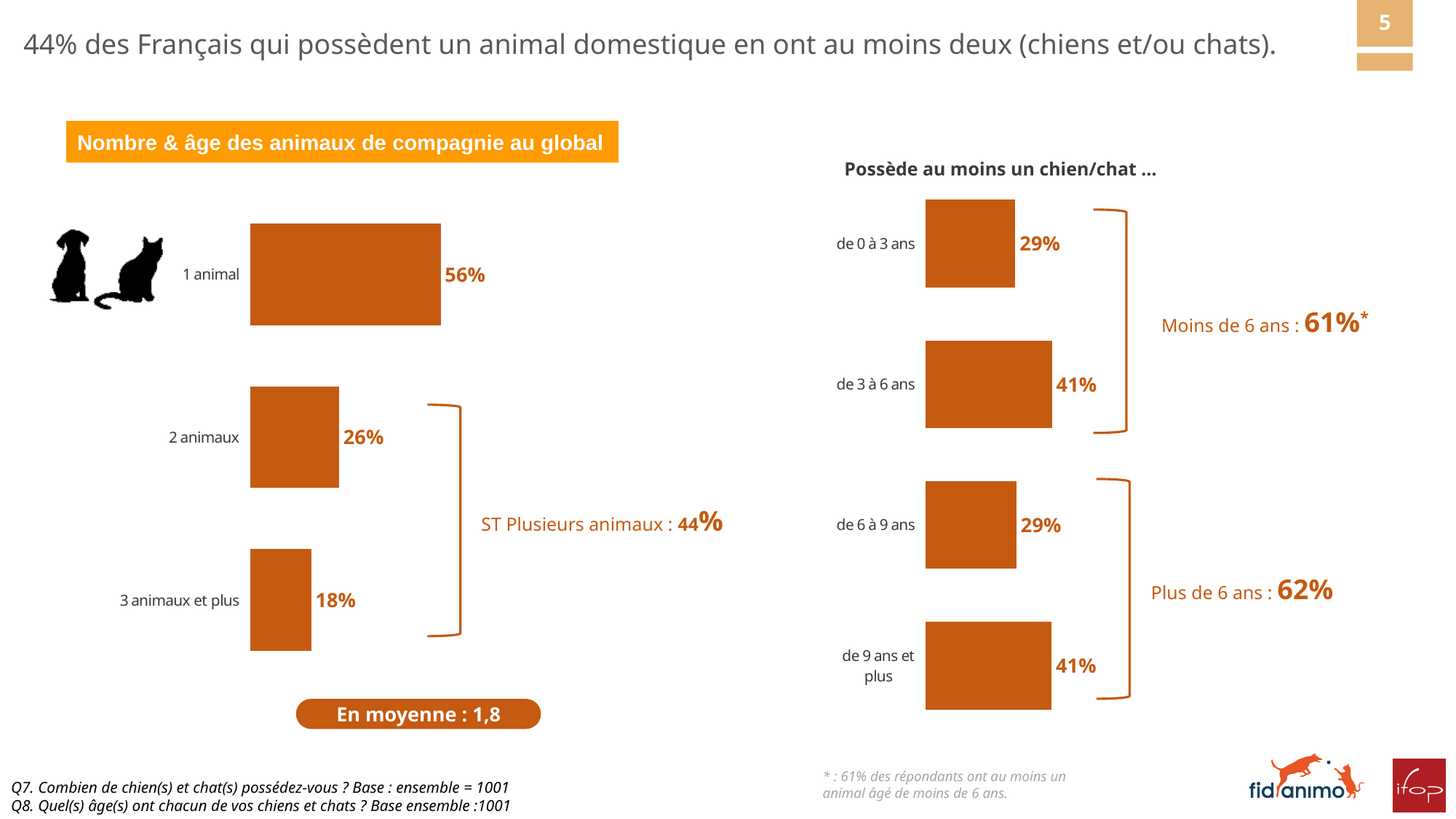
What is the value shown for 'ST Plusieurs animaux' on the left chart? 44% In the left chart (number of animals), how many categories are shown? 3 In the left chart (number of animals), which category has the lowest value? 3 animaux et plus In the left chart (number of animals), which category has the highest value? 1 animal In the left chart (number of animals), what is the value for '3 animaux et plus'? 18% What type of chart is used on the left side of the slide? Bar chart In the right chart ('Possède au moins un chien/chat ...'), what is the value for 'de 6 à 9 ans'? 29% In the left chart (number of animals), what is the difference between '1 animal' and '2 animaux'? 30 percentage points In the right chart ('Possède au moins un chien/chat ...'), how many age categories are shown? 4 In the left chart (number of animals), what is the value for '1 animal'? 56% In the right chart ('Possède au moins un chien/chat ...'), what is the value for 'de 3 à 6 ans'? 41% In the right chart ('Possède au moins un chien/chat ...'), which is larger: 'de 0 à 3 ans' or 'de 9 ans et plus'? de 9 ans et plus